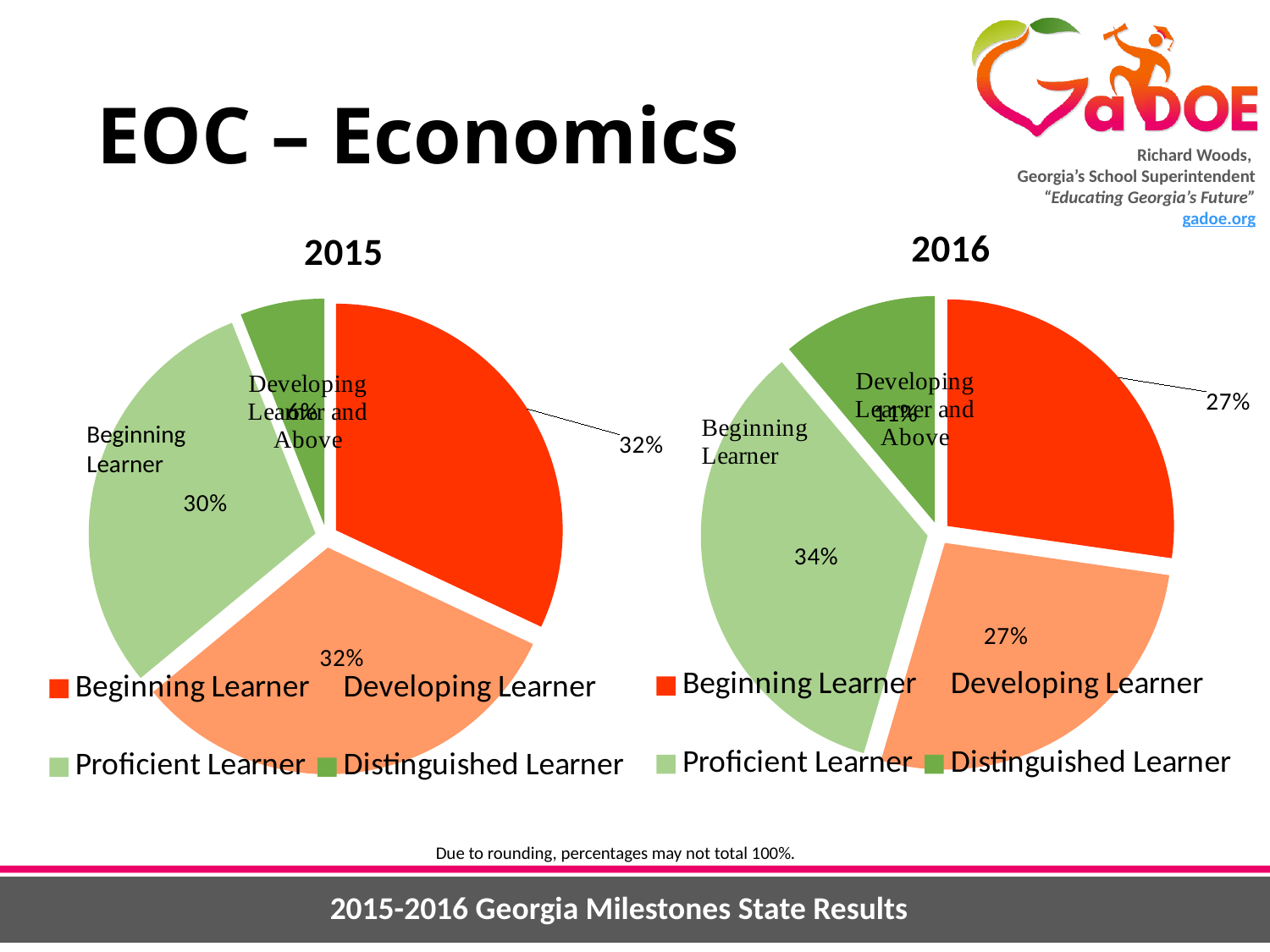
In the 2016 pie chart, what percentage is shown for Beginning Learner? 27% What kind of chart is used for the 2015 and 2016 results on this slide? Pie chart In the 2016 pie chart, what percentage is shown for Proficient Learner? 34% In the 2015 pie chart, what percentage is shown for Beginning Learner? 32% In the 2016 pie chart, which category has the smallest share? Distinguished Learner In the 2016 pie chart, what is the difference between the Proficient Learner and Beginning Learner percentages? 7 percentage points How many categories does the legend of the 2016 pie chart list? 4 By how many percentage points did the Proficient Learner share change from the 2015 chart to the 2016 chart? 4 percentage points In the 2015 pie chart, which is larger: Beginning Learner or Proficient Learner? Beginning Learner In the 2015 pie chart, which category has the smallest share? Distinguished Learner In the 2015 pie chart, what percentage is shown for Proficient Learner? 30% In the 2016 pie chart, which category has the largest share? Proficient Learner